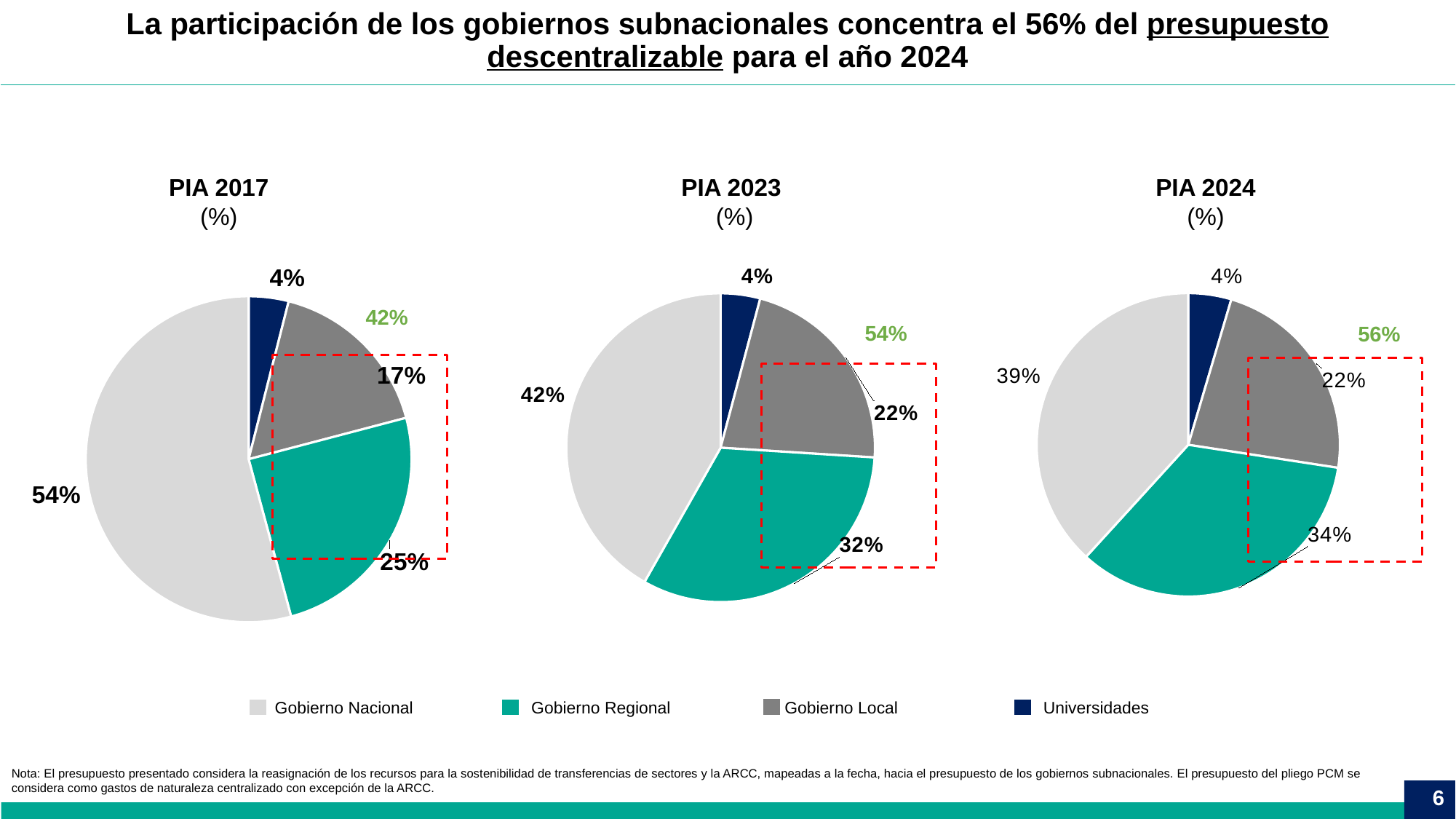
What type of chart is used for PIA 2017, PIA 2023 and PIA 2024? Pie chart In the PIA 2017 chart, which category has the smallest slice? Universidades Which colour represents Gobierno Regional in the legend? Teal In the PIA 2024 chart, what share does Gobierno Local have? 22% How many categories does the legend list? 4 In the PIA 2024 chart, what share does Universidades have? 4% In the PIA 2024 chart, which category has the largest slice? Gobierno Nacional In the PIA 2017 chart, which is larger, Gobierno Regional or Gobierno Local? Gobierno Regional In the PIA 2023 chart, what share does Gobierno Regional have? 32% In the PIA 2017 chart, what share does Gobierno Nacional have? 54% How many slices does the PIA 2023 pie chart have? 4 In the PIA 2023 chart, what is the difference between the Gobierno Nacional and Gobierno Regional shares? 10%